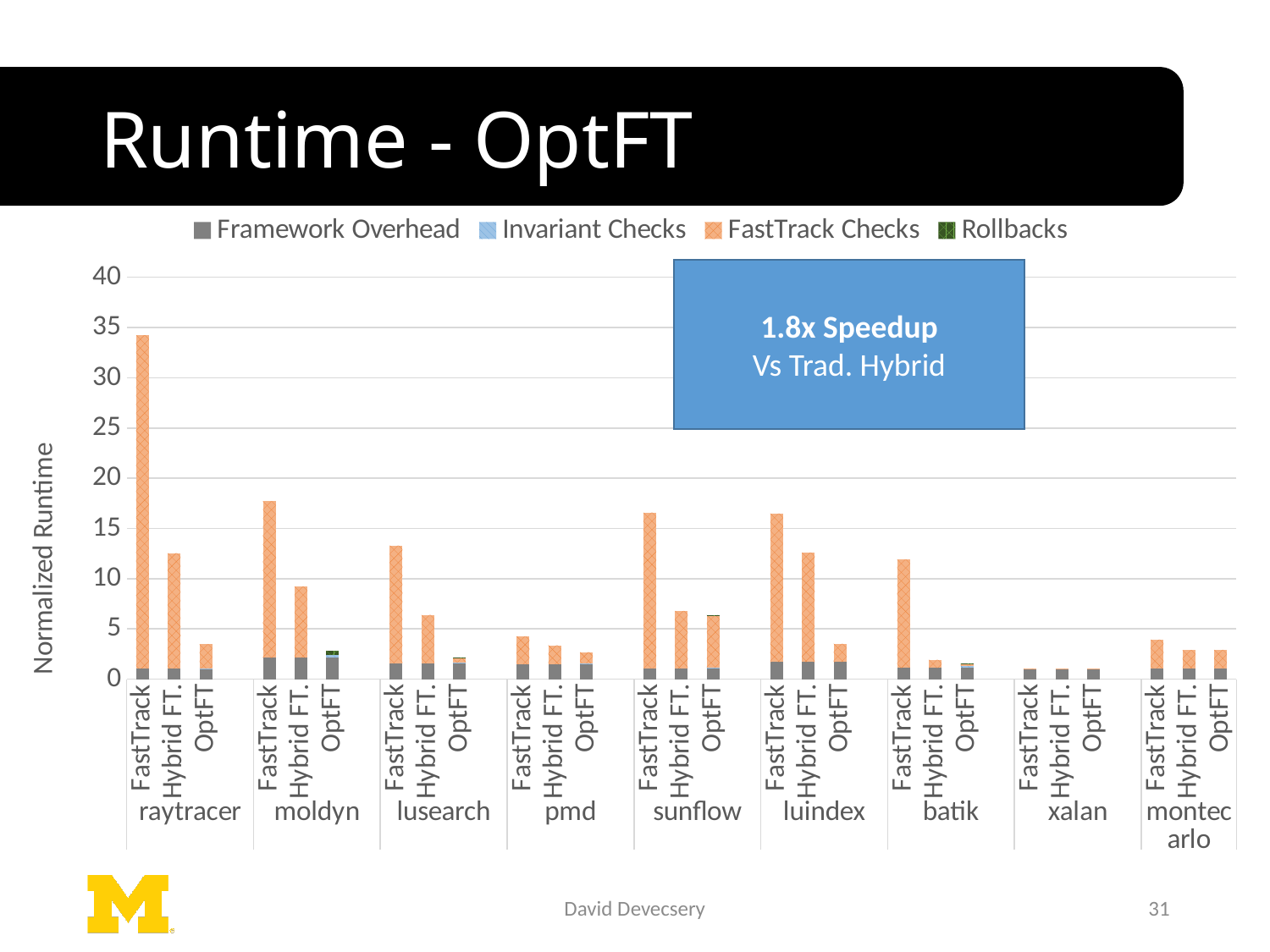
Is the Hybrid FT. value for raytracer greater or less than 10? greater What is the label of the y axis? Normalized Runtime Is the FastTrack value for raytracer greater or less than 30? greater Which bar is the tallest in the chart? FastTrack for raytracer How many benchmark groups are shown along the x axis? 9 Which benchmark has the lowest FastTrack bar? xalan Is the FastTrack value for pmd greater or less than 5? less What kind of chart is shown on the slide? stacked bar chart Which is larger, the Hybrid FT. bar for sunflow or the Hybrid FT. bar for luindex? luindex How many series does the legend list? 4 Which is larger for moldyn, the FastTrack bar or the OptFT bar? FastTrack